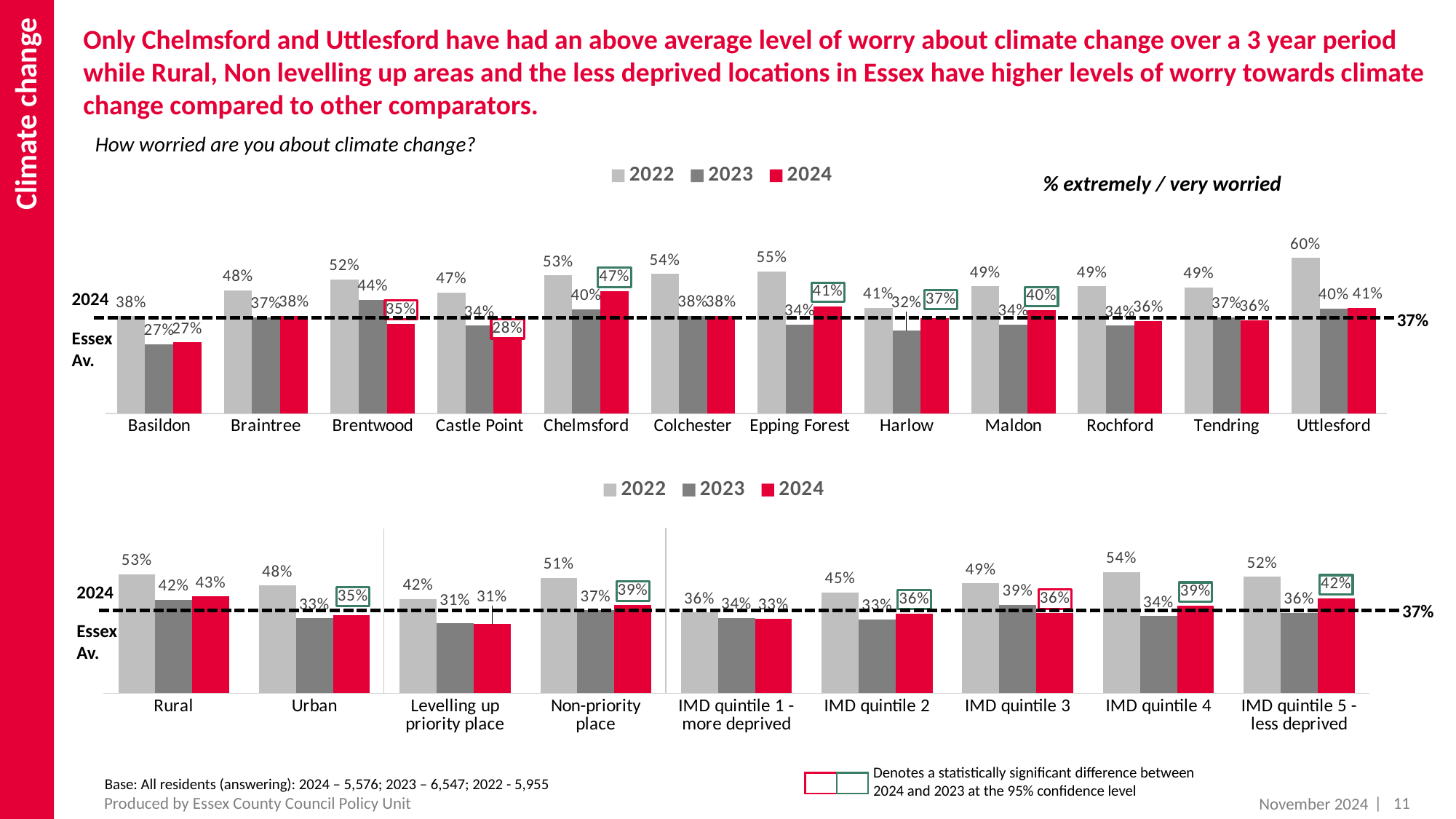
How many series does the legend of the top chart list? 3 In the top chart (by district), which district had the highest 2022 value? Uttlesford In the bottom chart, which category had the highest 2024 value? Rural In the top chart (by district), how many districts are shown on the x axis? 12 What type of chart is used on this slide? Bar chart In the top chart (by district), which is larger: the 2024 value for Brentwood or the 2024 value for Maldon? Maldon In the bottom chart, what was the 2023 value for Rural? 42% In the top chart (by district), what is the difference between the 2022 and 2024 values for Castle Point? 19 percentage points In the top chart (by district), what was the 2024 value for Chelmsford? 47% In the top chart (by district), which district had the lowest 2024 value? Basildon In the top chart (by district), what was the 2022 value for Uttlesford? 60% In the bottom chart, what is the difference between the 2024 values for IMD quintile 5 - less deprived and IMD quintile 1 - more deprived? 9 percentage points